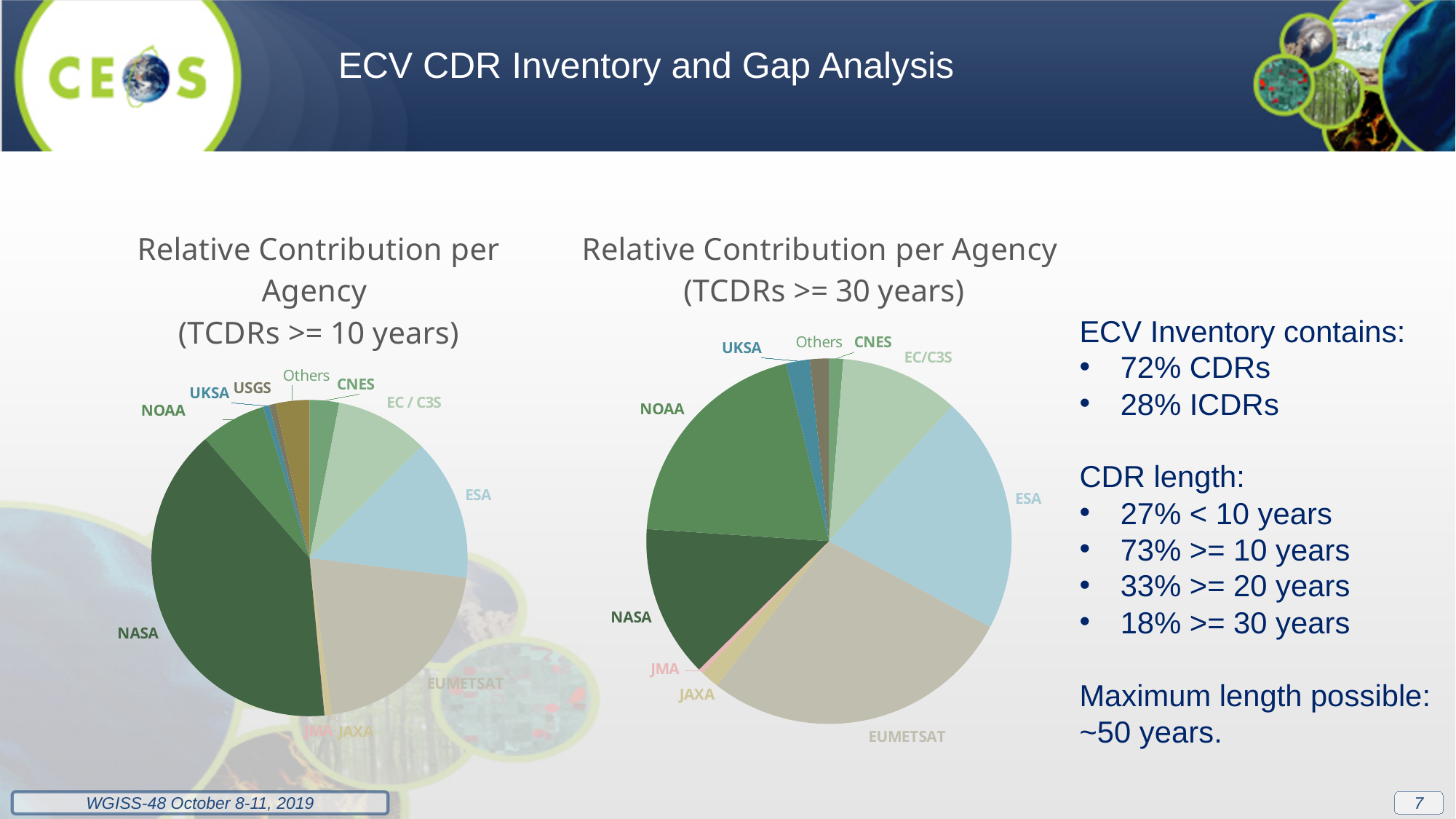
In the 'Relative Contribution per Agency (TCDRs >= 10 years)' chart, how many slices are labelled? 11 In the 'Relative Contribution per Agency (TCDRs >= 30 years)' chart, which slice is larger, ESA or EC/C3S? ESA What is the title of the pie chart on the left of the slide? Relative Contribution per Agency (TCDRs >= 10 years) Which agency appears in the 'Relative Contribution per Agency (TCDRs >= 10 years)' chart but not in the 'Relative Contribution per Agency (TCDRs >= 30 years)' chart? USGS In the 'Relative Contribution per Agency (TCDRs >= 10 years)' chart, which slice is larger, ESA or NOAA? ESA In the 'Relative Contribution per Agency (TCDRs >= 10 years)' chart, which agency has the largest slice? NASA In the 'Relative Contribution per Agency (TCDRs >= 30 years)' chart, how many slices are labelled? 10 What kind of chart is the 'Relative Contribution per Agency (TCDRs >= 30 years)' chart? pie chart In the 'Relative Contribution per Agency (TCDRs >= 30 years)' chart, which agency has the largest slice? EUMETSAT What kind of chart is the 'Relative Contribution per Agency (TCDRs >= 10 years)' chart? pie chart In the 'Relative Contribution per Agency (TCDRs >= 10 years)' chart, which slice is larger, NASA or EUMETSAT? NASA